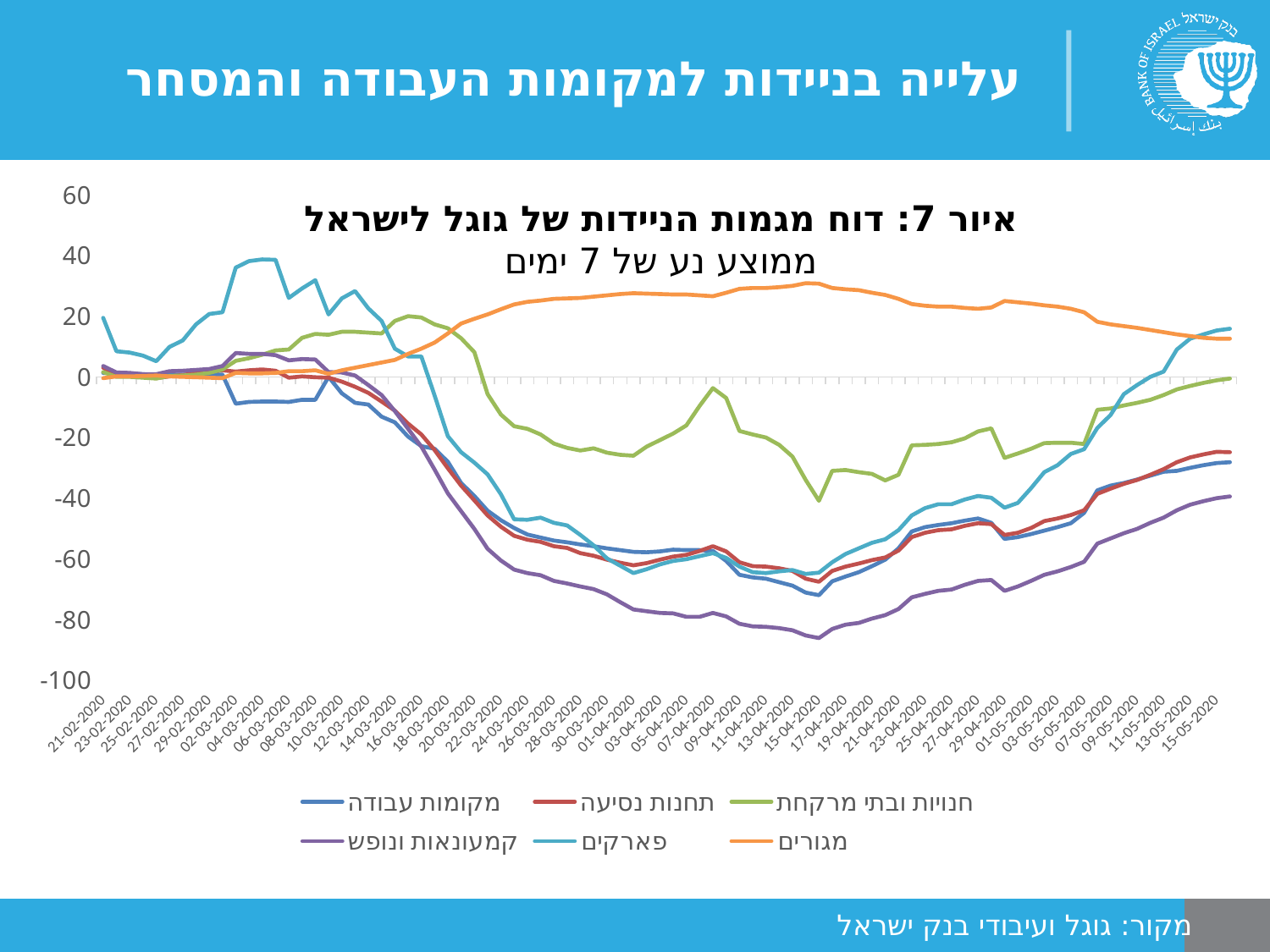
How many series does the legend list? 6 What kind of chart is shown on the slide? line chart Which series has the highest value on 15-04-2020? מגורים Which series has the lowest value on 17-04-2020? קמעונאות ונופש On 15-05-2020, which series has the higher value, מגורים or קמעונאות ונופש? מגורים Is the value for פארקים on 15-05-2020 greater or less than 0? greater What is the title of the chart? איור 7: דוח מגמות הניידות של גוגל לישראל Is the value for מגורים on 15-04-2020 greater or less than 20? greater What subtitle appears under the chart title? ממוצע נע של 7 ימים Does the מגורים series rise or fall between 21-02-2020 and 15-04-2020? rise Is the value for מקומות עבודה on 15-05-2020 greater or less than -20? less